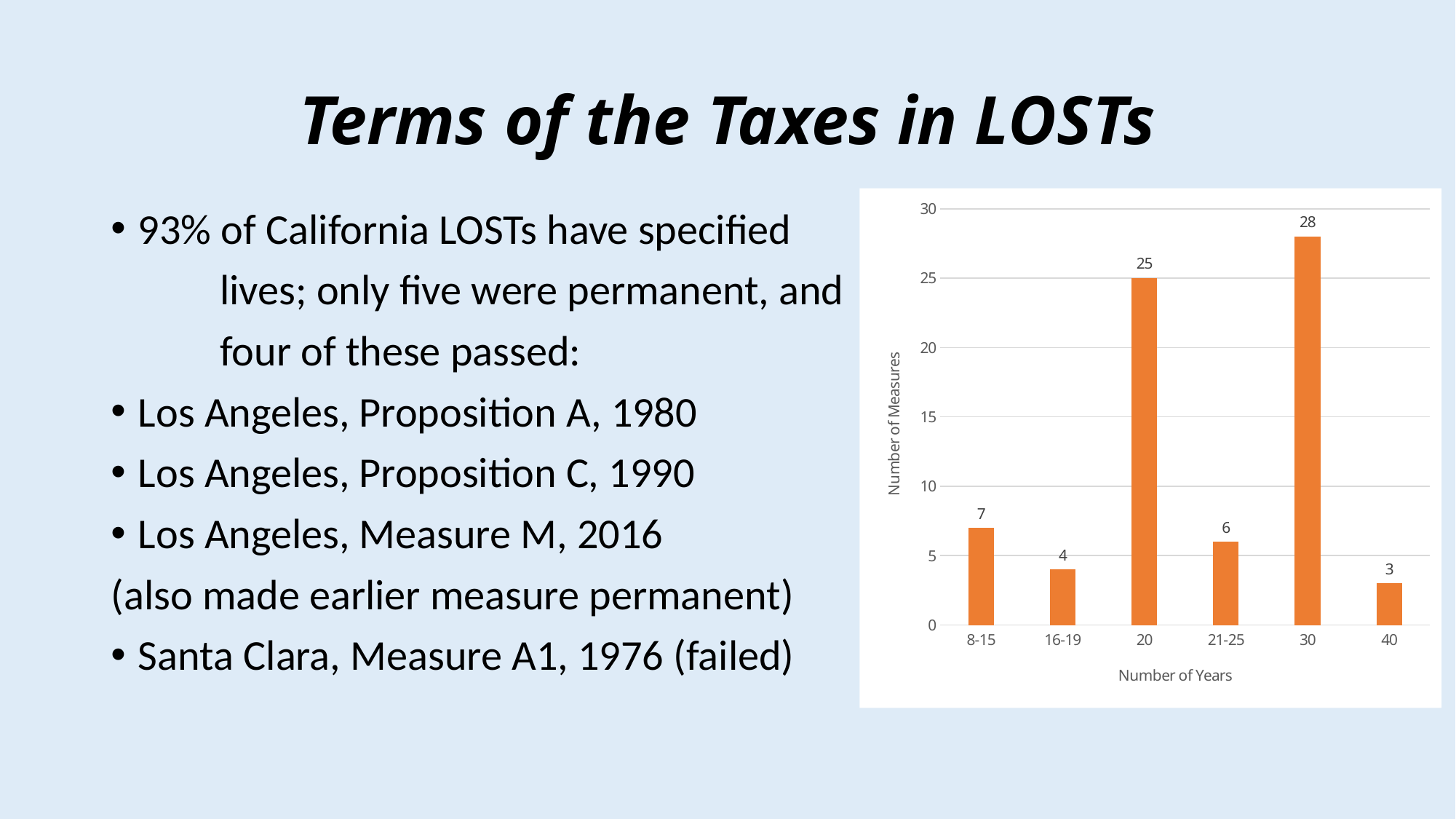
What is the label of the y axis of the chart? Number of Measures What is the number of measures for the 20-year term? 25 Which number-of-years category has the highest number of measures? 30 Which number-of-years category has the lowest number of measures? 40 Which has more measures, the 16-19 year term or the 21-25 year term? 21-25 Is the number of measures for the 30-year term greater or less than 25? greater How many number-of-years categories are shown on the x axis? 6 What is the label of the x axis of the chart? Number of Years What is the number of measures for the 8-15 year term? 7 What kind of chart is shown on the slide? bar chart What is the difference in number of measures between the 30-year and 20-year terms? 3 What is the number of measures for the 40-year term? 3